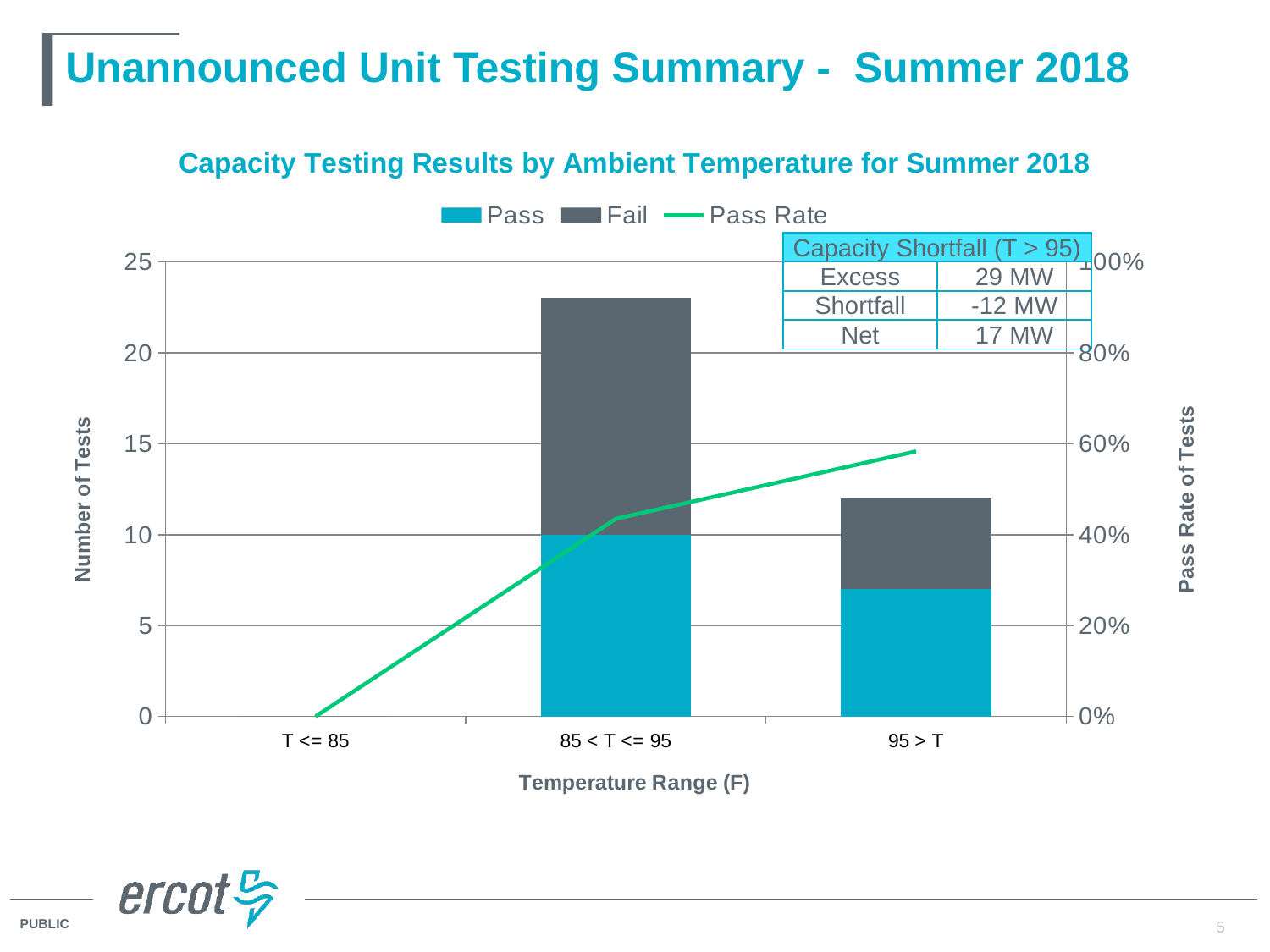
Does the Pass Rate line rise or fall as temperature range increases along the x axis? Rises Is the total number of tests for 85 < T <= 95 greater or less than 20? greater Which temperature range has the lowest total number of tests? T <= 85 In the 85 < T <= 95 range, which is larger, the number of Pass tests or the number of Fail tests? Fail How many temperature range categories are shown on the x axis? 3 Is the total number of tests for 95 > T greater or less than 10? greater What kind of chart is shown on the slide? Stacked bar chart with a line How many series does the legend list? 3 How many tests passed in the 85 < T <= 95 temperature range? 10 What is the Pass Rate for the T <= 85 temperature range? 0% Is the Pass Rate for 95 > T greater or less than 60%? less Which temperature range has the highest total number of tests? 85 < T <= 95